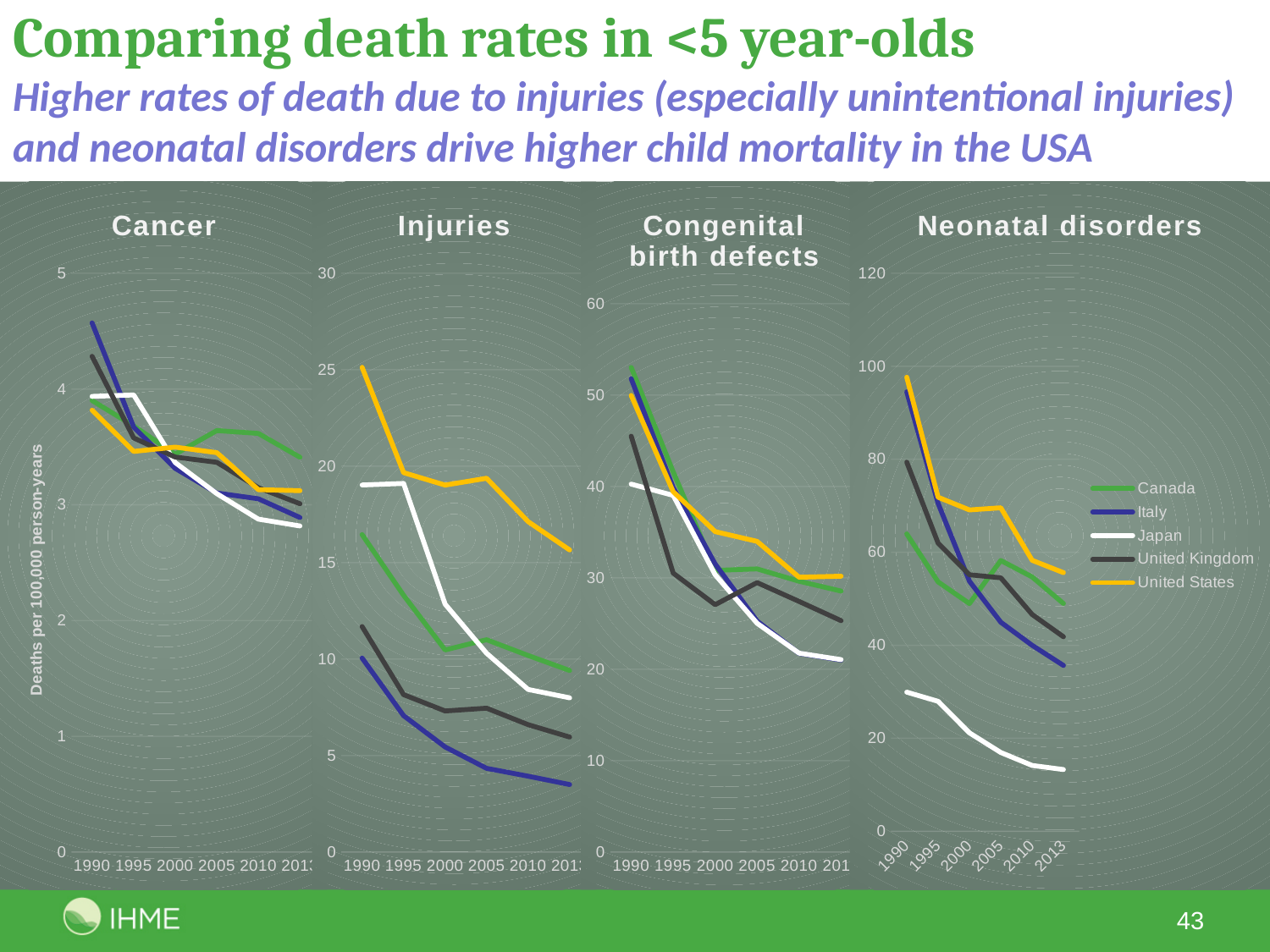
In the Neonatal disorders chart, is the value for Japan in 2013 greater or less than 20? less In the Injuries chart, which country has the highest value in 1990? United States In the Injuries chart, which is larger in 2013: the United States or Italy? United States In the Injuries chart, is the value for the United States in 1990 greater or less than 20? greater In the Neonatal disorders chart, is the value for the United States in 1990 greater or less than 80? greater What kind of chart is the Injuries chart? line chart How many years are marked on the x axis of the Cancer chart? 6 What is the label on the y axis of the Cancer chart? Deaths per 100,000 person-years How many series does the legend list? 5 In the Injuries chart, does the value for Japan rise or fall from 1990 to 2013? fall In the Neonatal disorders chart, which country has the lowest value in 2013? Japan